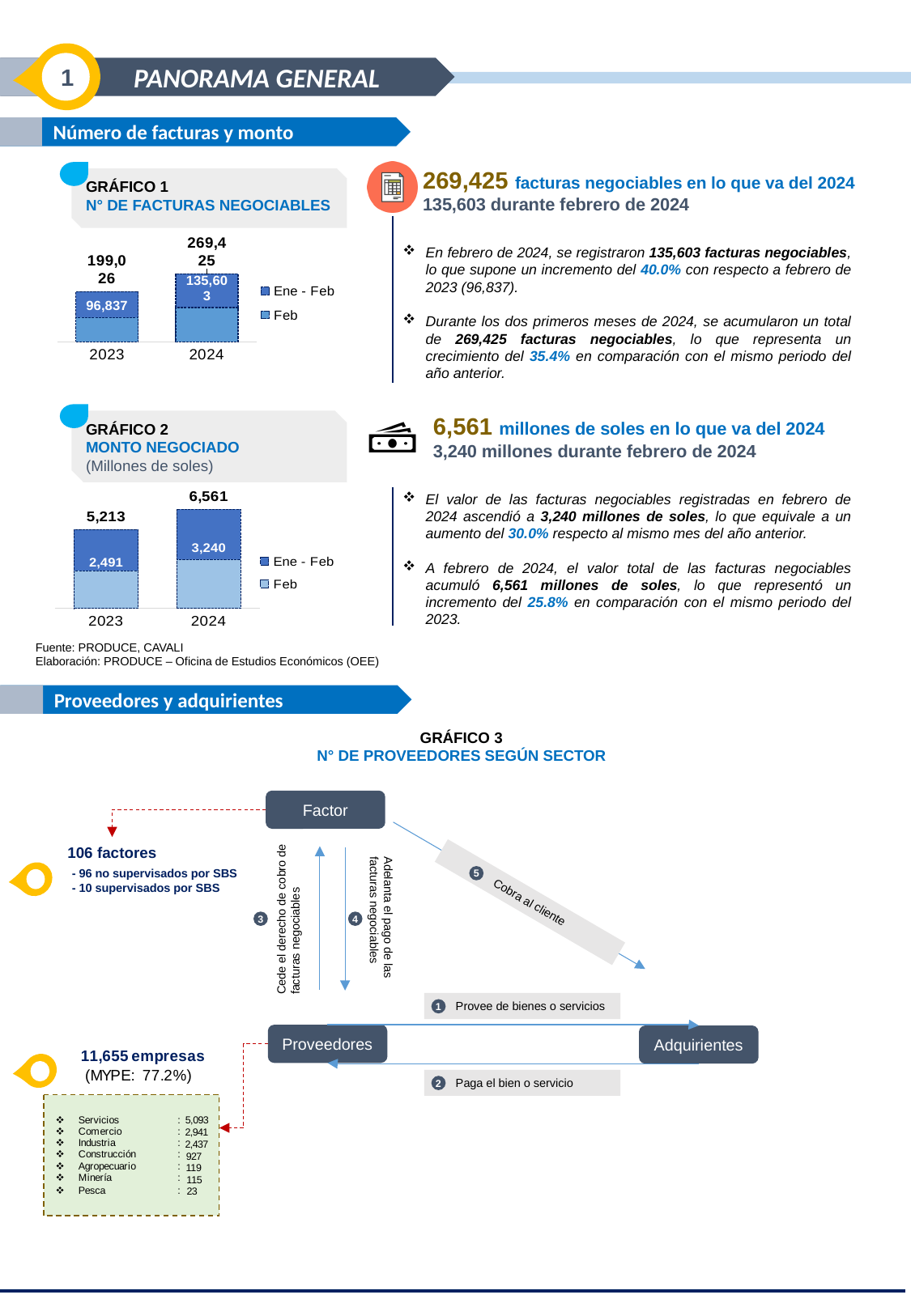
In Gráfico 2 (Monto negociado), what is the Feb value for 2024? 3,240 In Gráfico 2 (Monto negociado), what is the Ene - Feb value for 2023? 5,213 In Gráfico 2 (Monto negociado), what unit is stated in the chart title? Millones de soles In Gráfico 2 (Monto negociado), how many years are shown on the x axis? 2 In Gráfico 2 (Monto negociado), which year has the higher Ene - Feb value? 2024 In Gráfico 1 (N° de facturas negociables), what is the difference between the Ene - Feb values for 2024 and 2023? 70,399 What kind of chart is Gráfico 1 (N° de facturas negociables)? Bar chart In Gráfico 2 (Monto negociado), what is the difference between the Feb values for 2024 and 2023? 749 In Gráfico 1 (N° de facturas negociables), what is the Ene - Feb value for 2024? 269,425 In Gráfico 1 (N° de facturas negociables), what is the Feb value for 2023? 96,837 In Gráfico 1 (N° de facturas negociables), how many series does the legend list? 2 In Gráfico 3 (N° de proveedores según sector), how many proveedores are listed for the Comercio sector? 2,941